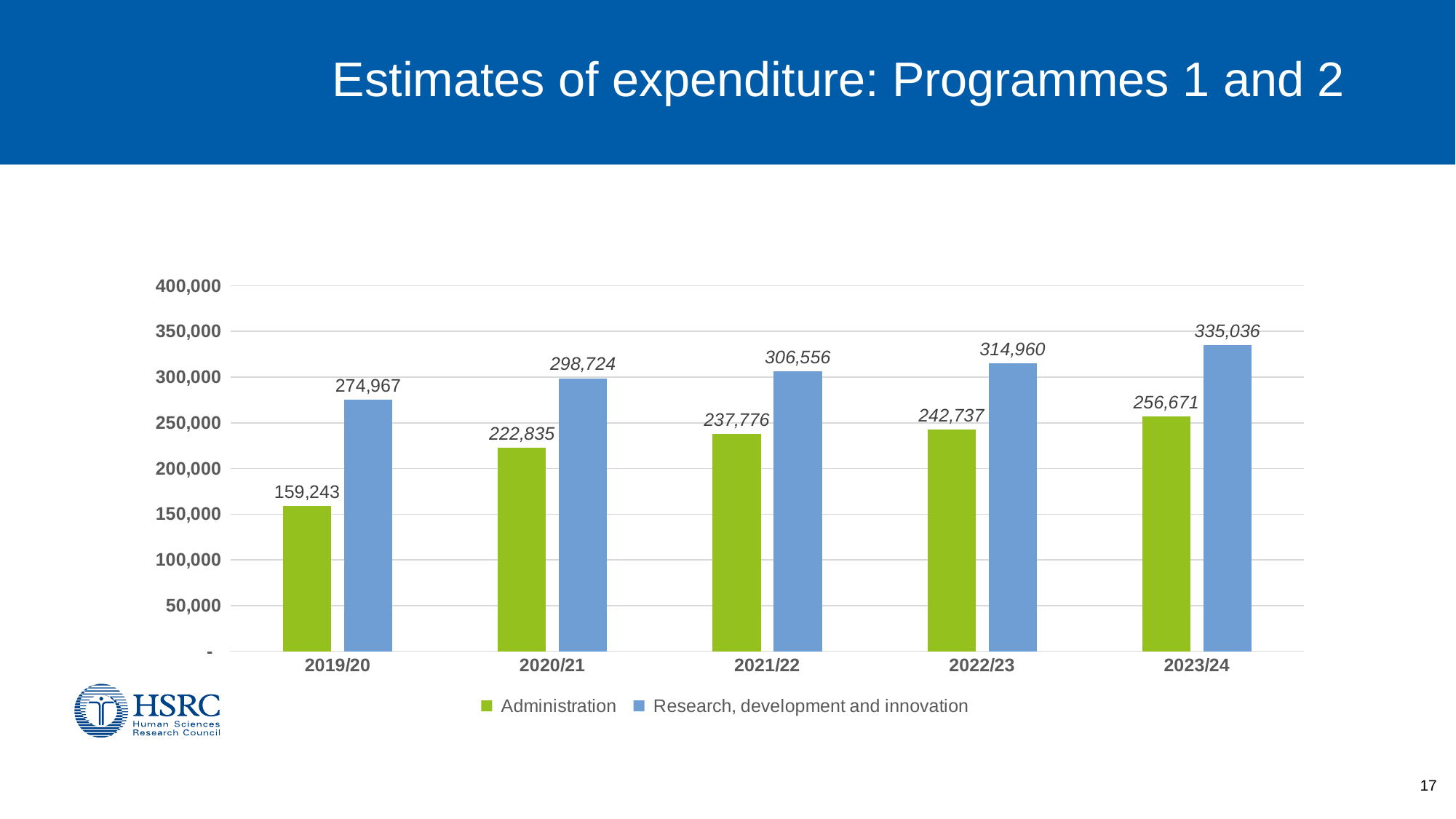
What is the difference between the Research, development and innovation value and the Administration value in 2022/23? 72,223 How many years are shown on the x axis? 5 How many series does the legend list? 2 What is the Research, development and innovation value for 2023/24? 335,036 Which is larger in 2020/21: Administration or Research, development and innovation? Research, development and innovation In which year is the Research, development and innovation value lowest? 2019/20 What kind of chart is shown on the slide? Bar chart What is the Administration value for 2019/20? 159,243 What is the Administration value for 2021/22? 237,776 Do the Administration values rise or fall from 2019/20 to 2023/24? Rise In which year is the Administration value highest? 2023/24 What is the Research, development and innovation value for 2020/21? 298,724